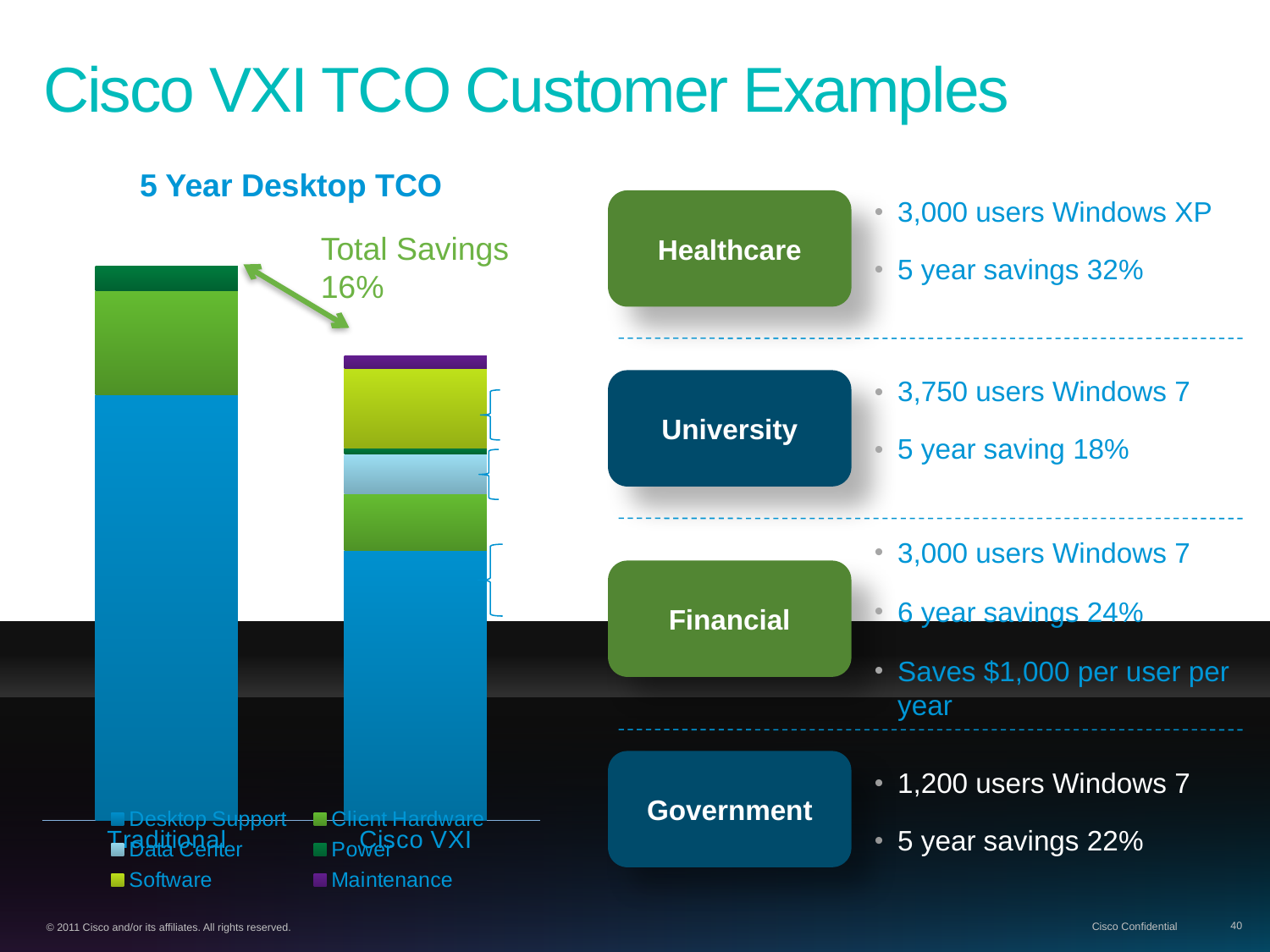
Which series in the chart is shown in purple? Maintenance What total savings percentage is annotated on the chart between the two bars? 16% How many series does the chart legend list? 6 What is the title of the chart on the slide? 5 Year Desktop TCO Which bar is taller, Traditional or Cisco VXI? Traditional Do the bar totals rise or fall from Traditional to Cisco VXI? Fall Which category has the highest total 5 Year Desktop TCO? Traditional How many categories (bars) does the chart show? 2 Which category has the lowest total 5 Year Desktop TCO? Cisco VXI Which series forms the largest segment of the Traditional bar? Desktop Support What kind of chart is shown on the slide? Stacked bar chart